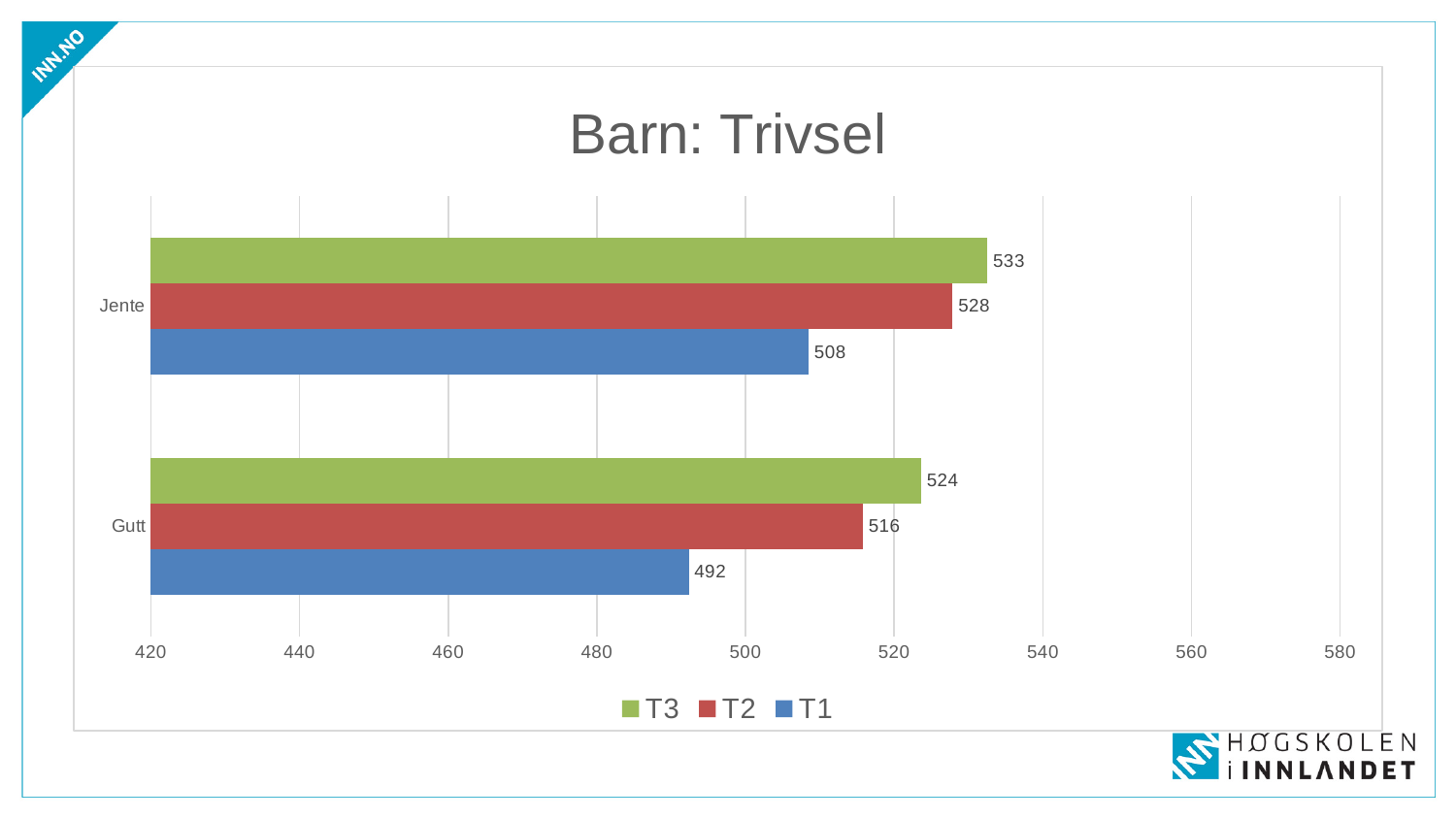
What kind of chart is shown on the slide? Bar chart How many series does the legend list? 3 Which category has the highest value in series T1? Jente Which category has the lowest value in series T3? Gutt What is the difference between the T3 and T1 values for Gutt? 32 What is the value for Jente in series T2? 528 What is the title of the chart? Barn: Trivsel What is the difference between the Jente and Gutt values in series T2? 12 Which is larger: the T1 value for Jente or the T2 value for Gutt? T2 value for Gutt What is the value for Jente in series T3? 533 What is the value for Gutt in series T2? 516 What is the value for Gutt in series T1? 492